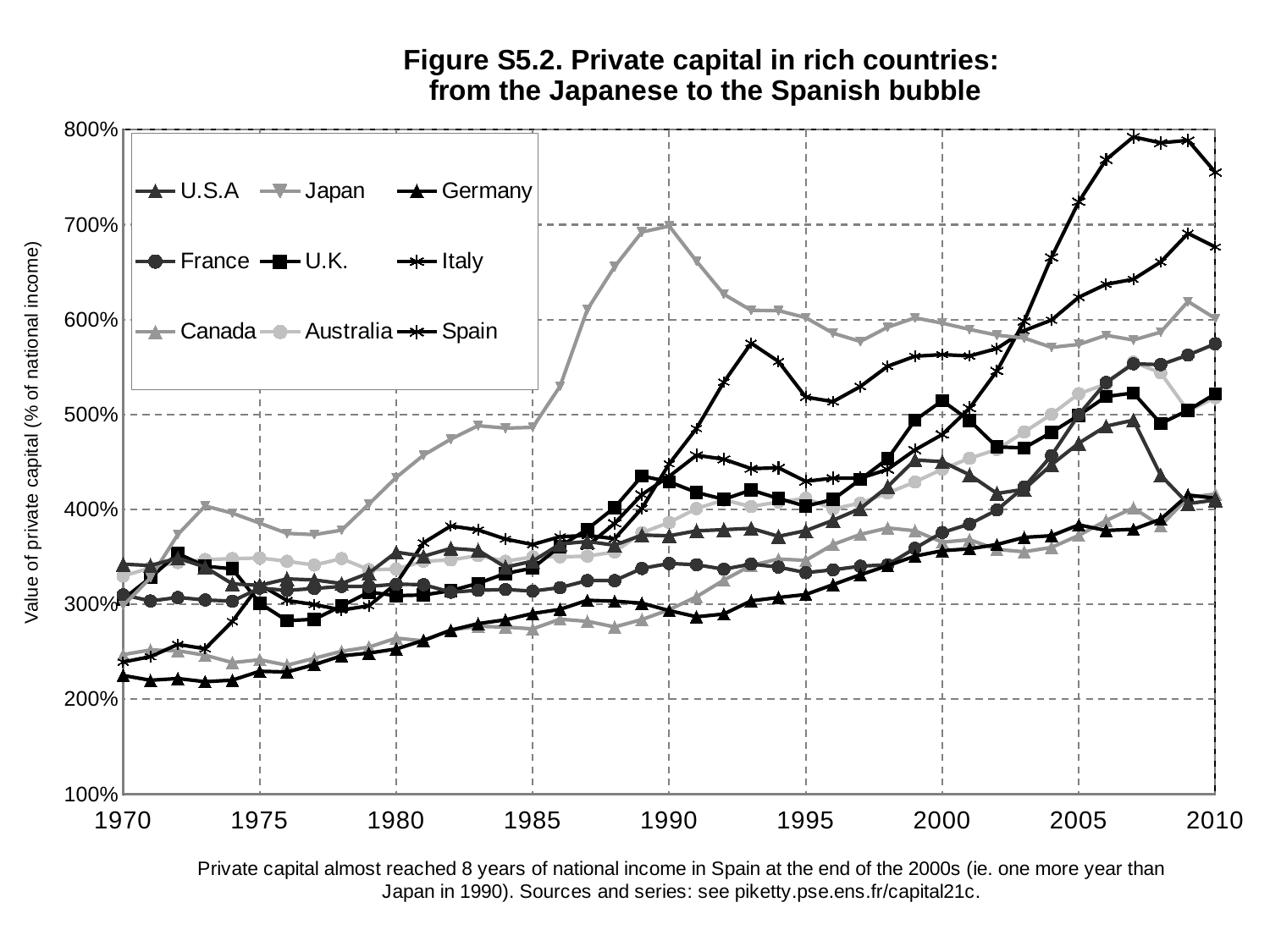
Which country has the lowest value of private capital in 1970? Germany Is the value for Spain in 2007 greater or less than 700%? greater How many series does the legend list? 9 Which country has the highest value of private capital in 2010? Spain Does the value for Spain rise or fall between 2000 and 2007? rise What is the label of the vertical axis? Value of private capital (% of national income) Is the value for Italy in 2010 greater or less than 600%? greater What is the title of the chart? Figure S5.2. Private capital in rich countries: from the Japanese to the Spanish bubble Which country has the highest value of private capital in 1990? Japan Is the value for Germany in 1970 greater or less than 300%? less Does the value for Japan rise or fall between 1990 and 2000? fall What kind of chart is shown on the slide? Line chart